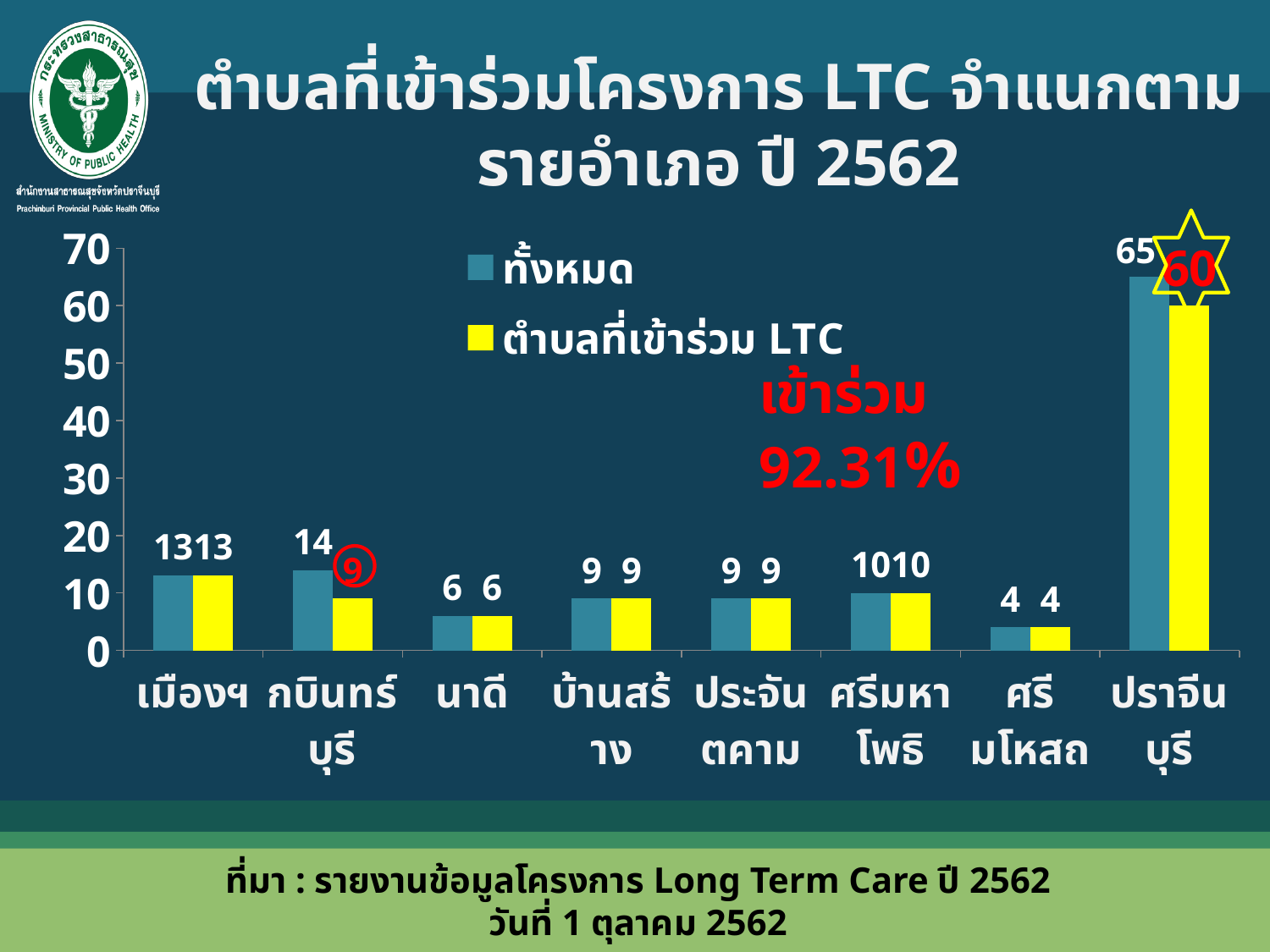
What kind of chart is shown on the slide? bar chart What is the ทั้งหมด value for ปราจีนบุรี? 65 What is the ทั้งหมด value for กบินทร์บุรี? 14 Which district has the lowest ทั้งหมด value? ศรีมโหสถ What is the difference between the ทั้งหมด and ตำบลที่เข้าร่วม LTC values for ปราจีนบุรี? 5 Which district has the highest ทั้งหมด value? ปราจีนบุรี How many districts (categories) are shown on the x axis? 8 Which is larger: the ทั้งหมด value for นาดี or the ทั้งหมด value for ศรีมหาโพธิ? ศรีมหาโพธิ What is the ตำบลที่เข้าร่วม LTC value for ศรีมโหสถ? 4 How many series does the legend list? 2 What is the ตำบลที่เข้าร่วม LTC value for กบินทร์บุรี? 9 What overall participation percentage is printed on the chart? 92.31%